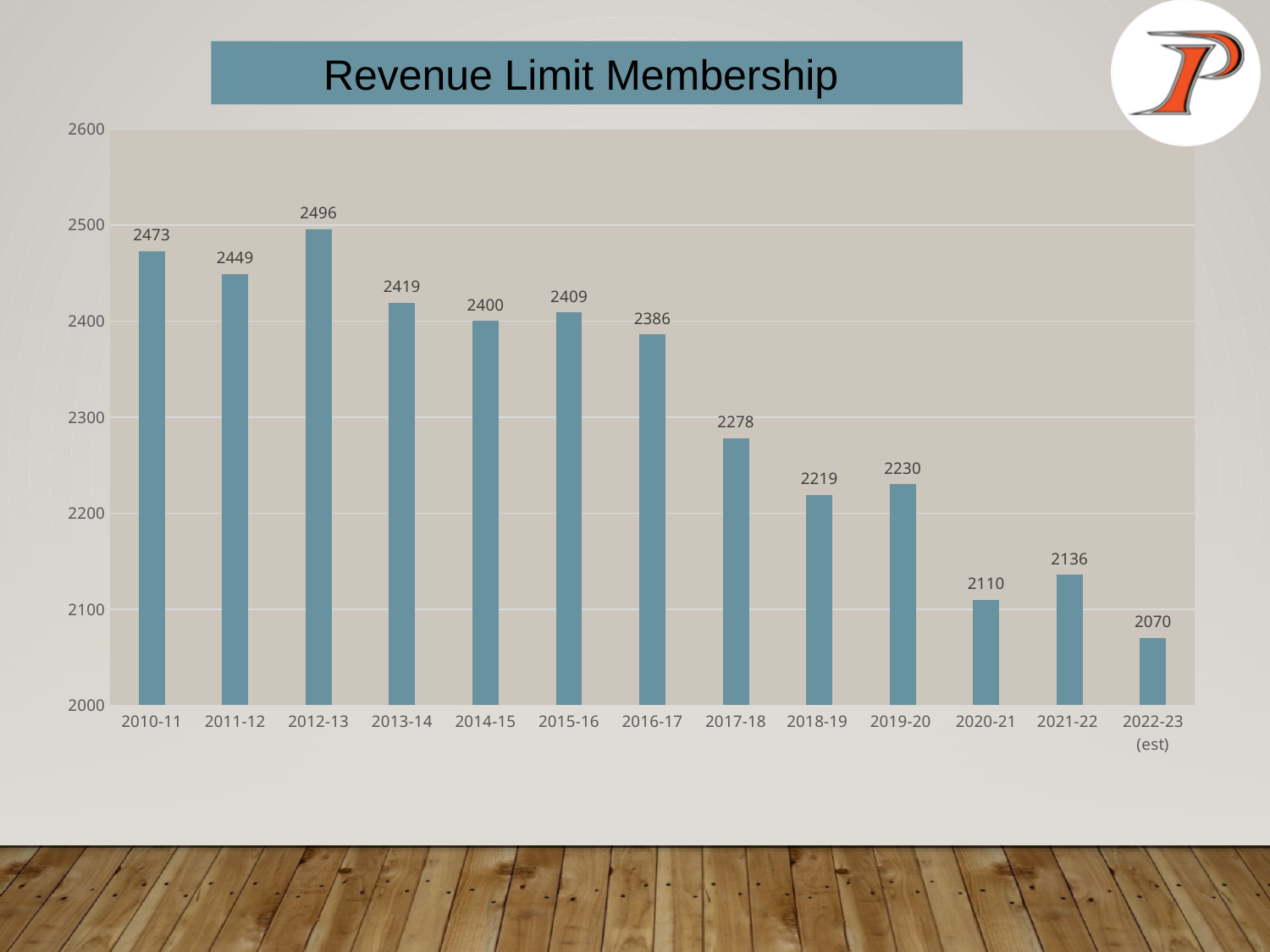
What is the revenue limit membership for 2012-13? 2496 What is the revenue limit membership for 2018-19? 2219 Which year has the highest revenue limit membership? 2012-13 Which year has the lowest revenue limit membership? 2022-23 (est) Which year has a larger membership, 2019-20 or 2020-21? 2019-20 What is the difference in membership between 2016-17 and 2017-18? 108 What is the estimated revenue limit membership for 2022-23? 2070 What kind of chart is shown on the slide? Bar chart How many years are shown on the chart? 13 What is the overall trend in revenue limit membership from 2010-11 to 2022-23? Falling What is the difference in membership between 2010-11 and 2021-22? 337 Is the membership for 2015-16 greater or less than 2400? greater